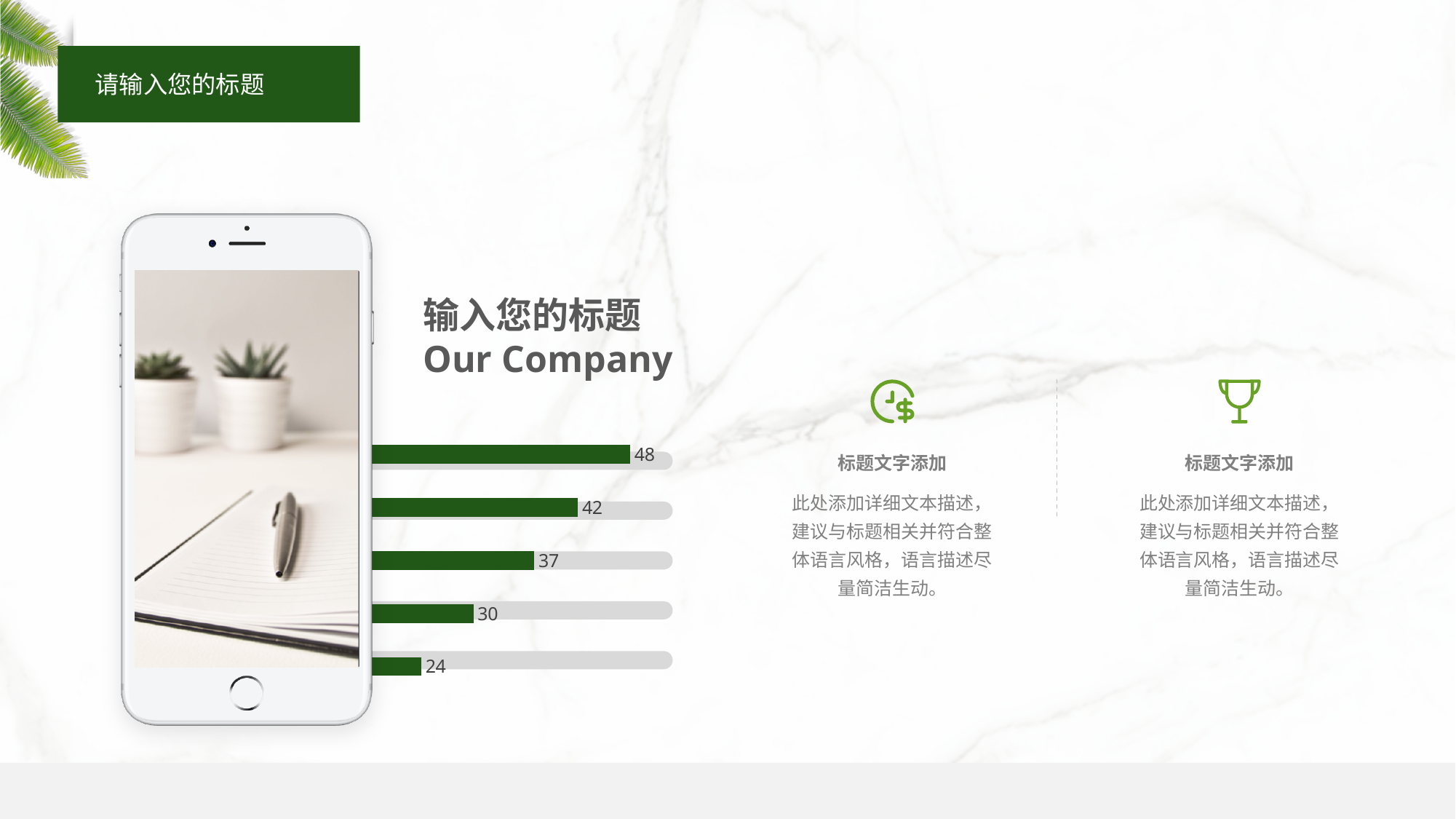
What kind of chart is shown on the slide? bar chart How many bars does the chart contain? 5 What is the value of the fourth bar from the top? 30 What is the value of the top bar in the chart? 48 What is the lowest value shown in the chart? 24 What is the difference between the top bar and the bottom bar? 24 What is the value of the bottom bar in the chart? 24 What is the value of the middle (third) bar in the chart? 37 What is the highest value shown in the chart? 48 Do the bar values increase or decrease from the top bar to the bottom bar? decrease Which is larger, the second bar from the top or the fourth bar from the top? the second bar from the top What is the value of the second bar from the top? 42